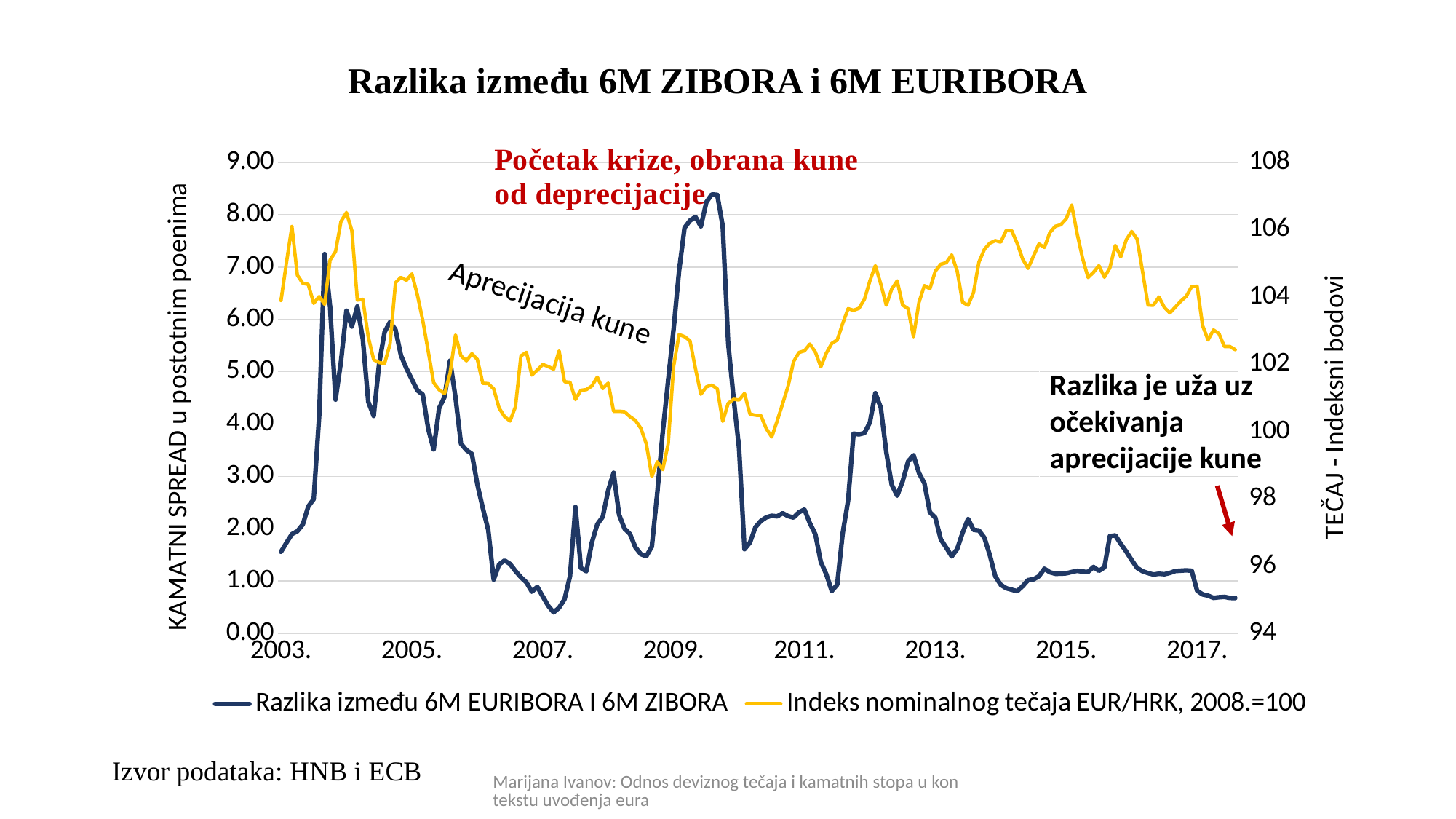
Is the value of the 'Indeks nominalnog tečaja EUR/HRK, 2008.=100' series at the start of 2003 greater or less than 102? greater How many series does the legend list? 2 How many year labels are shown on the x axis? 8 What is the title of the chart? Razlika između 6M ZIBORA i 6M EURIBORA Does the 'Razlika između 6M EURIBORA I 6M ZIBORA' series rise or fall overall from 2012 to 2017? fall What kind of chart is shown on the slide? line chart Does the 'Indeks nominalnog tečaja EUR/HRK, 2008.=100' series rise or fall overall from 2009 to 2015? rise Is the lowest value of the 'Razlika između 6M EURIBORA I 6M ZIBORA' series around 2007 greater or less than 1.00? less Is the peak value of the 'Razlika između 6M EURIBORA I 6M ZIBORA' series in late 2009 greater or less than 7.00? greater Which series is drawn with the yellow line? Indeks nominalnog tečaja EUR/HRK, 2008.=100